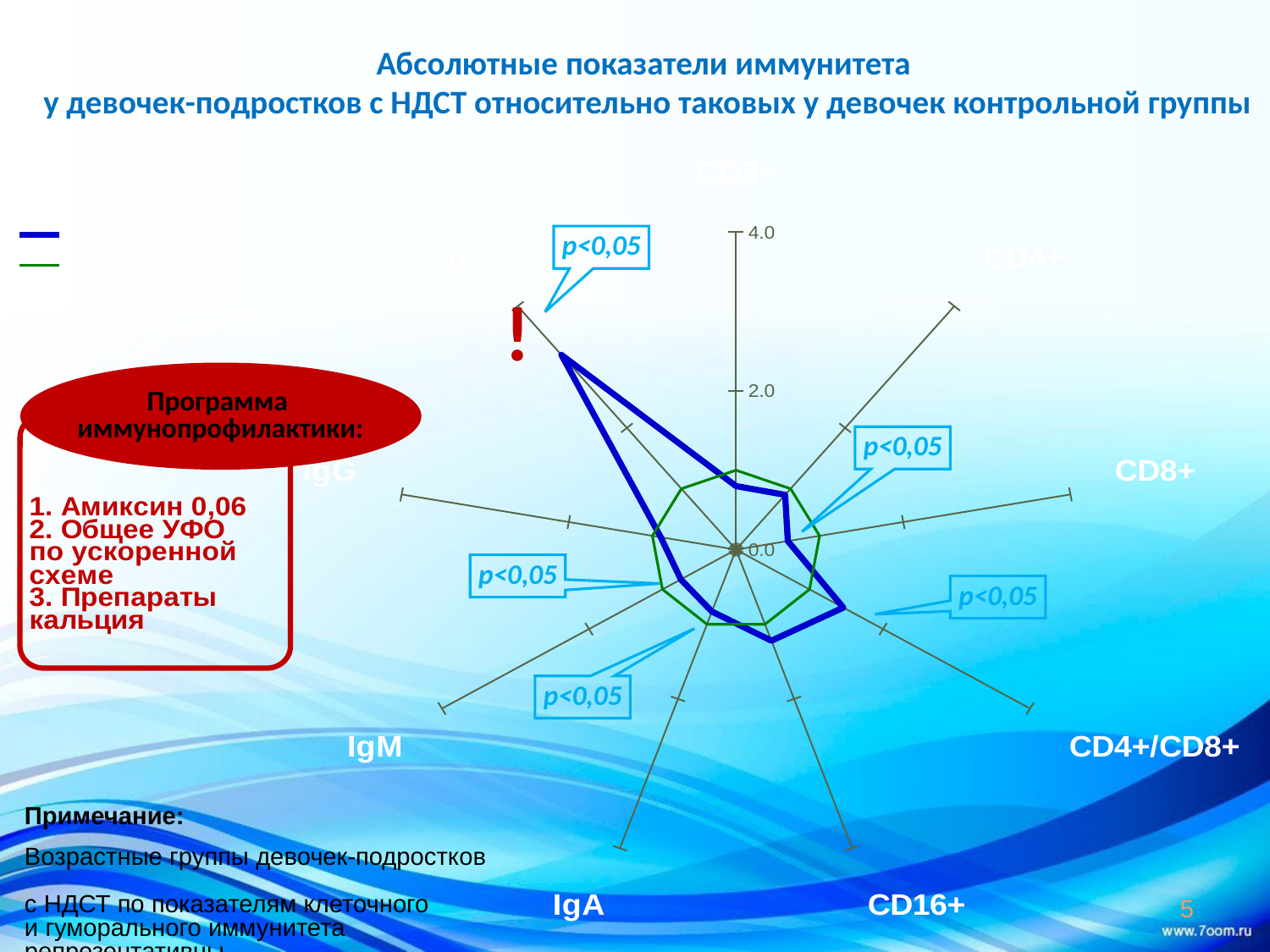
On the CD8+ axis, which series has the larger value, the blue or the green one? green What is the highest value marked on the radial axis of the chart? 4.0 On the IgM axis, which series has the larger value, the blue or the green one? green On the CD4+/CD8+ axis, which series has the larger value, the blue or the green one? blue Is the blue series value on the CD16+ axis greater or less than 2.0? less What kind of chart is shown on the slide? radar chart Is the green series value on the IgA axis greater or less than 2.0? less Is the blue series value on the IgM axis greater or less than 2.0? less How many "p<0,05" callouts are placed on the chart? 5 How many data series are plotted on the radar chart? 2